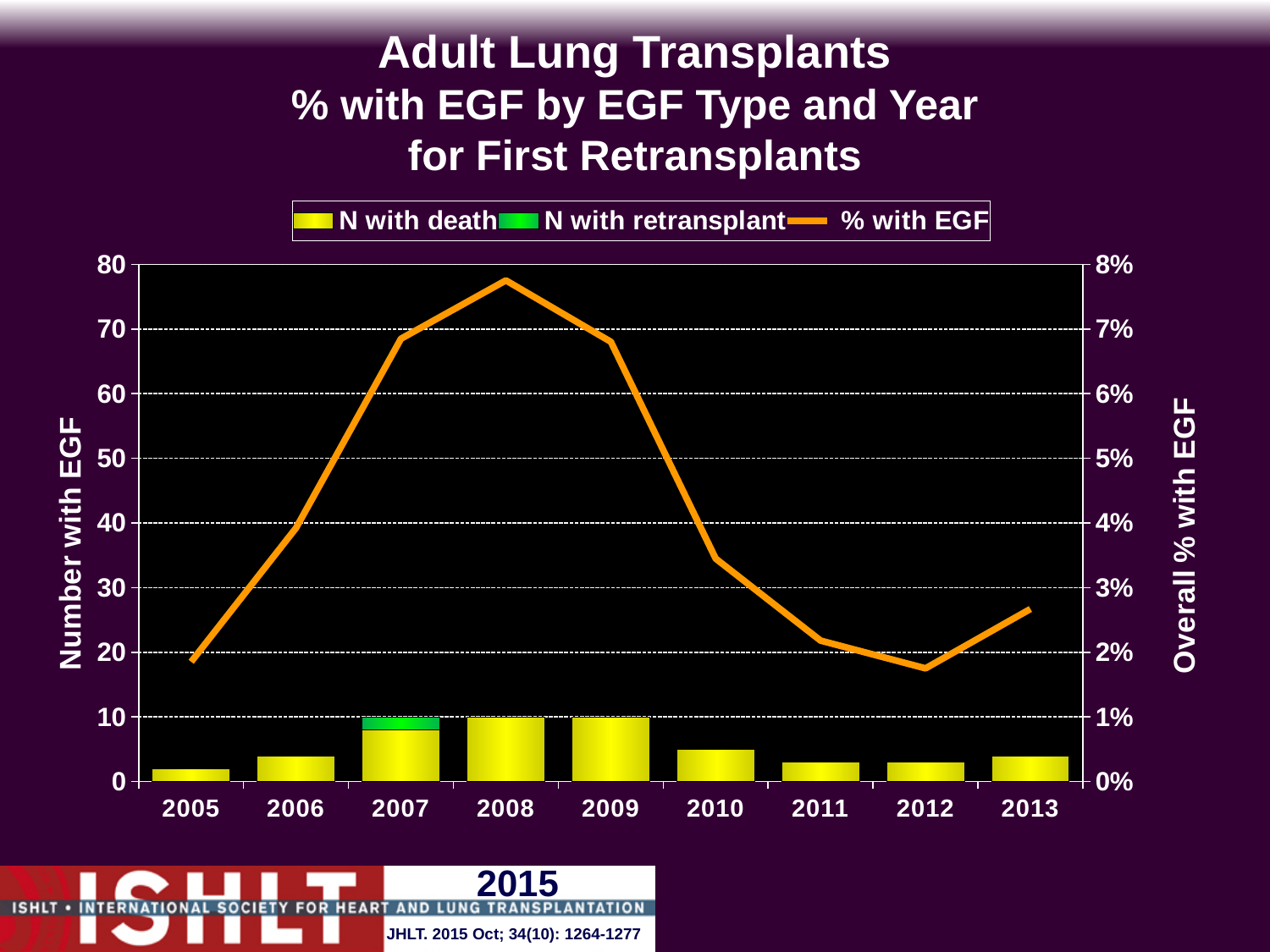
What is the title of the right-hand vertical axis? Overall % with EGF What kind of chart is shown on the slide? A combination bar and line chart In which year does the % with EGF line reach its highest point? 2008 How many series does the legend list? 3 Which year is the only one with a green 'N with retransplant' segment in its bar? 2007 Is the number with EGF bar for 2006 greater or less than 10? less How many years are shown on the x axis of the chart? 9 Is the % with EGF value for 2008 greater or less than 7%? greater Is the % with EGF value for 2010 greater or less than 4%? less Which year has the shortest bar for number with EGF? 2005 Which year has a higher % with EGF, 2007 or 2010? 2007 Does the % with EGF line rise or fall from 2009 to 2012? It falls